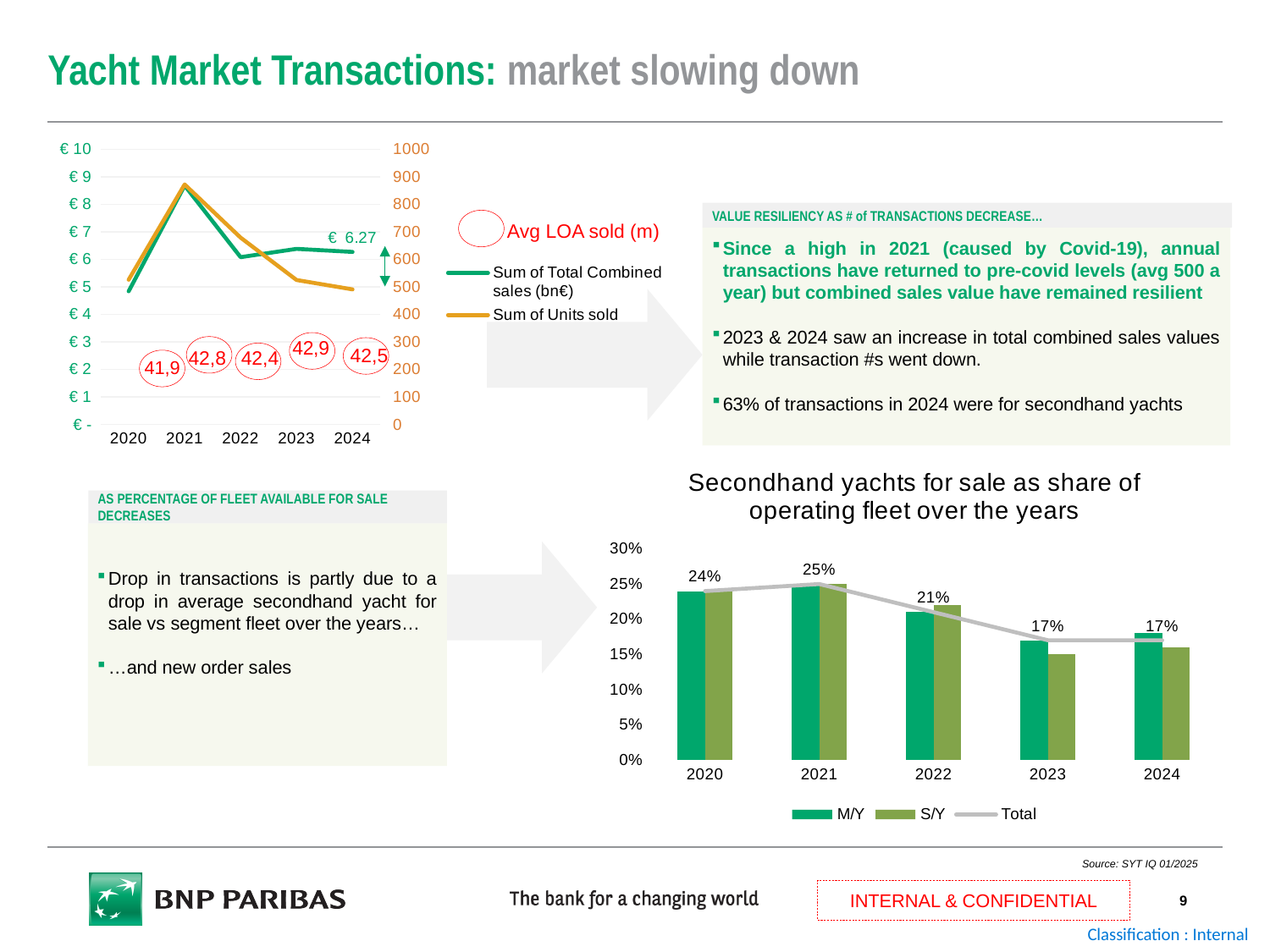
In the top-left chart, which year has the highest Avg LOA sold (m) value? 2023 In the top-left chart, in which year does Sum of Units sold peak? 2021 In the chart 'Secondhand yachts for sale as share of operating fleet over the years', do the labelled values rise or fall from 2021 to 2024? fall In the chart 'Secondhand yachts for sale as share of operating fleet over the years', what is the difference between the labelled values for 2021 and 2022? 4 percentage points In the top-left chart, is the Sum of Units sold for 2021 greater or less than 800? greater In the chart 'Secondhand yachts for sale as share of operating fleet over the years', which is larger in 2023, the M/Y bar or the S/Y bar? M/Y In the top-left chart, is the Sum of Total Combined sales for 2021 greater or less than € 8? greater How many series does the legend of the chart 'Secondhand yachts for sale as share of operating fleet over the years' list? 3 In the top-left chart, what is the Avg LOA sold (m) value shown for 2021? 42,8 In the top-left chart, what is the Avg LOA sold (m) value shown for 2020? 41,9 In the chart 'Secondhand yachts for sale as share of operating fleet over the years', what percentage is labelled for 2021? 25% In the top-left chart, what data label is shown for Sum of Total Combined sales in 2024? € 6.27